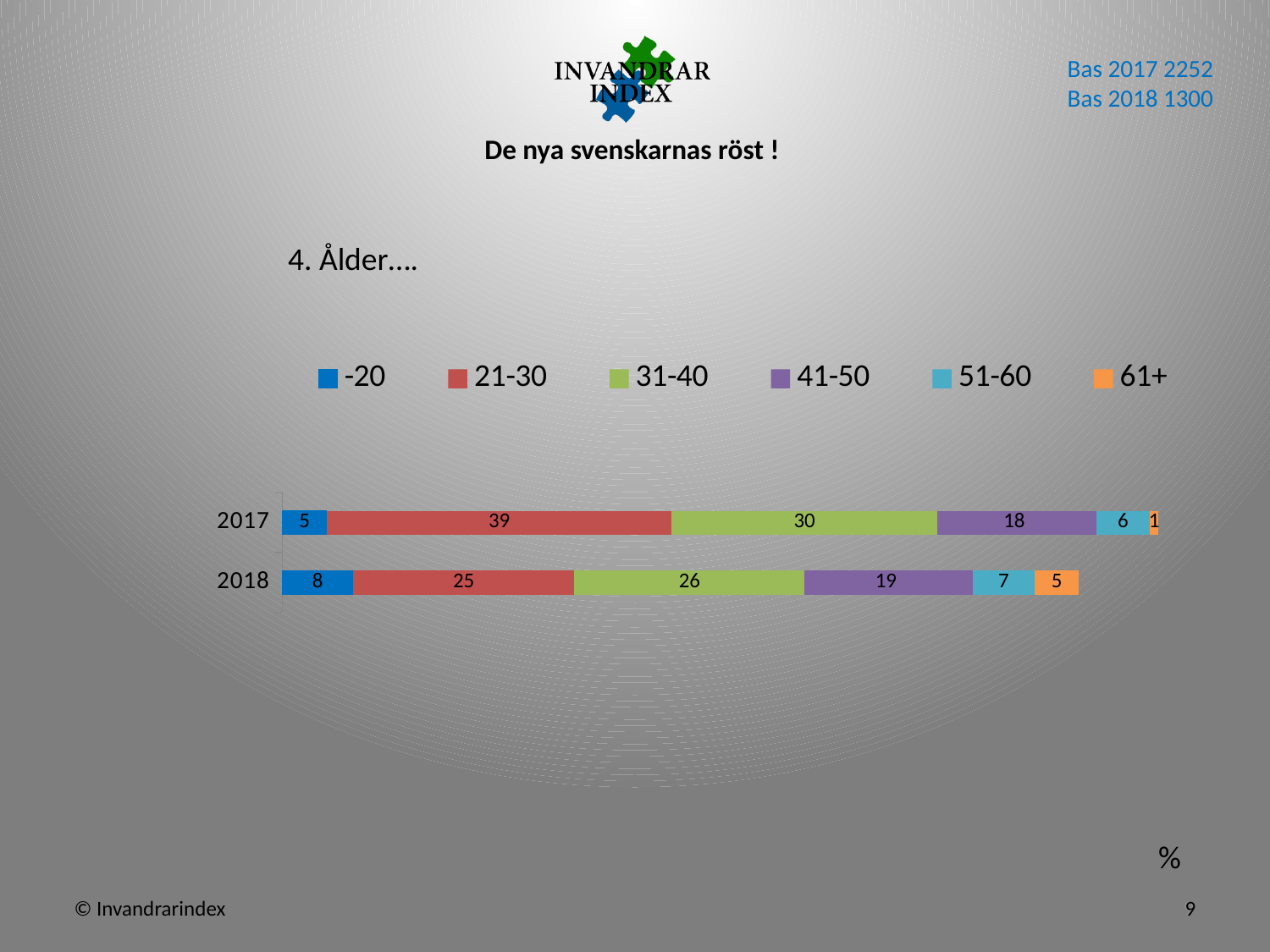
What is the value for the 61+ age group in 2017? 1 What is the value for the 21-30 age group in 2017? 39 What is the total of the stacked bar for 2018? 90 What is the difference between the 21-30 values for 2017 and 2018? 14 Which age group has the lowest value in 2018? 61+ What is the value for the -20 age group in 2018? 8 Which age group has the highest value in 2017? 21-30 How many categories (years) are plotted on the chart? 2 What is the value for the 31-40 age group in 2018? 26 How many series does the legend list? 6 Which is larger, the 41-50 value for 2017 or for 2018? 2018 What kind of chart is shown on the slide? stacked bar chart